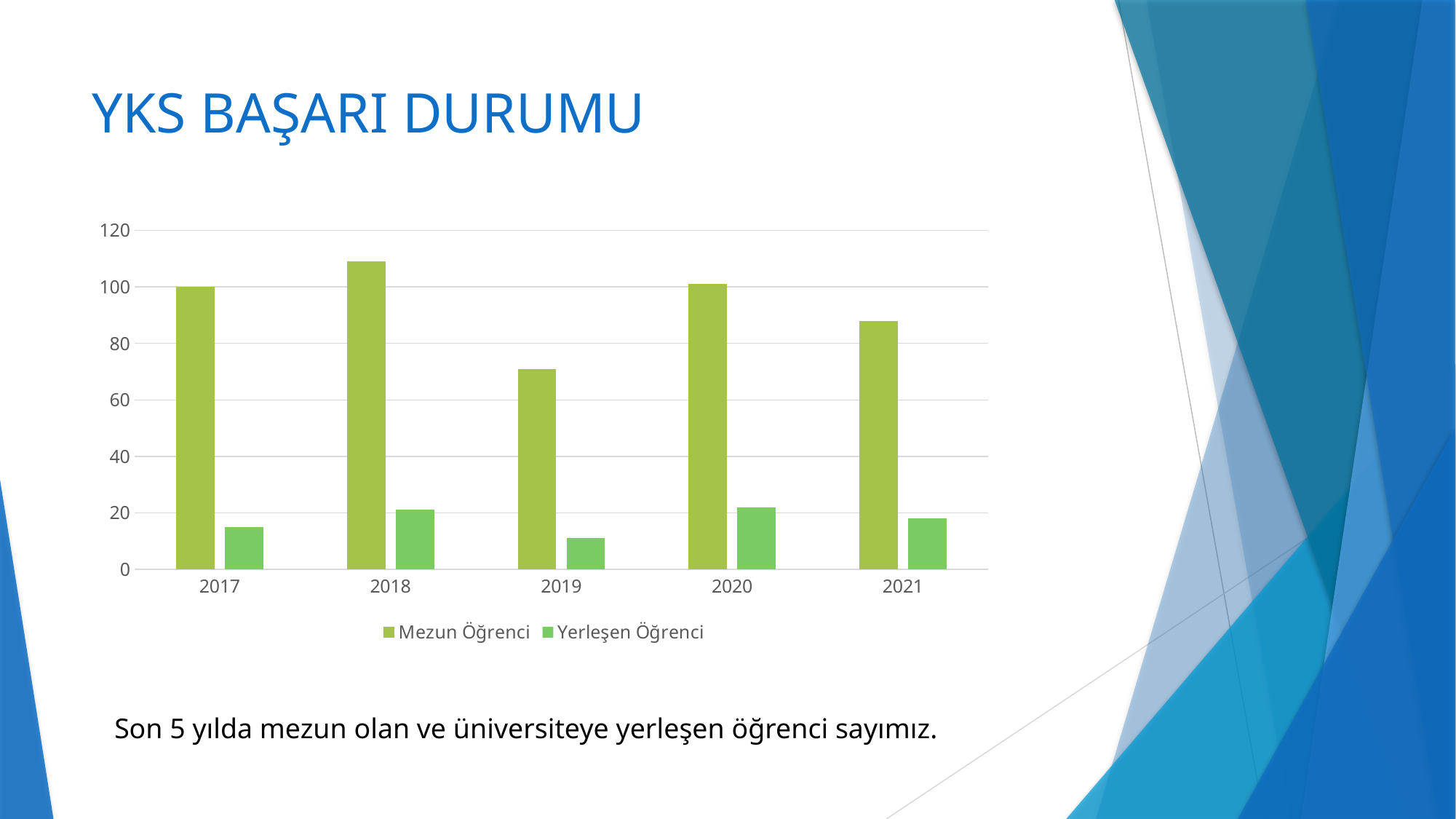
How many years are shown on the x axis of the chart? 5 Is the value for Mezun Öğrenci in 2018 greater or less than 100? greater How many series does the chart legend list? 2 Which year has the lowest value for Yerleşen Öğrenci? 2019 Which is larger: Mezun Öğrenci in 2020 or Mezun Öğrenci in 2021? 2020 What are the two series named in the chart legend? Mezun Öğrenci and Yerleşen Öğrenci What kind of chart is shown on the slide? bar chart Which year has the highest value for Mezun Öğrenci? 2018 Which year has the lowest value for Mezun Öğrenci? 2019 Is the value for Yerleşen Öğrenci in 2019 greater or less than 20? less Is the value for Mezun Öğrenci in 2019 greater or less than 80? less